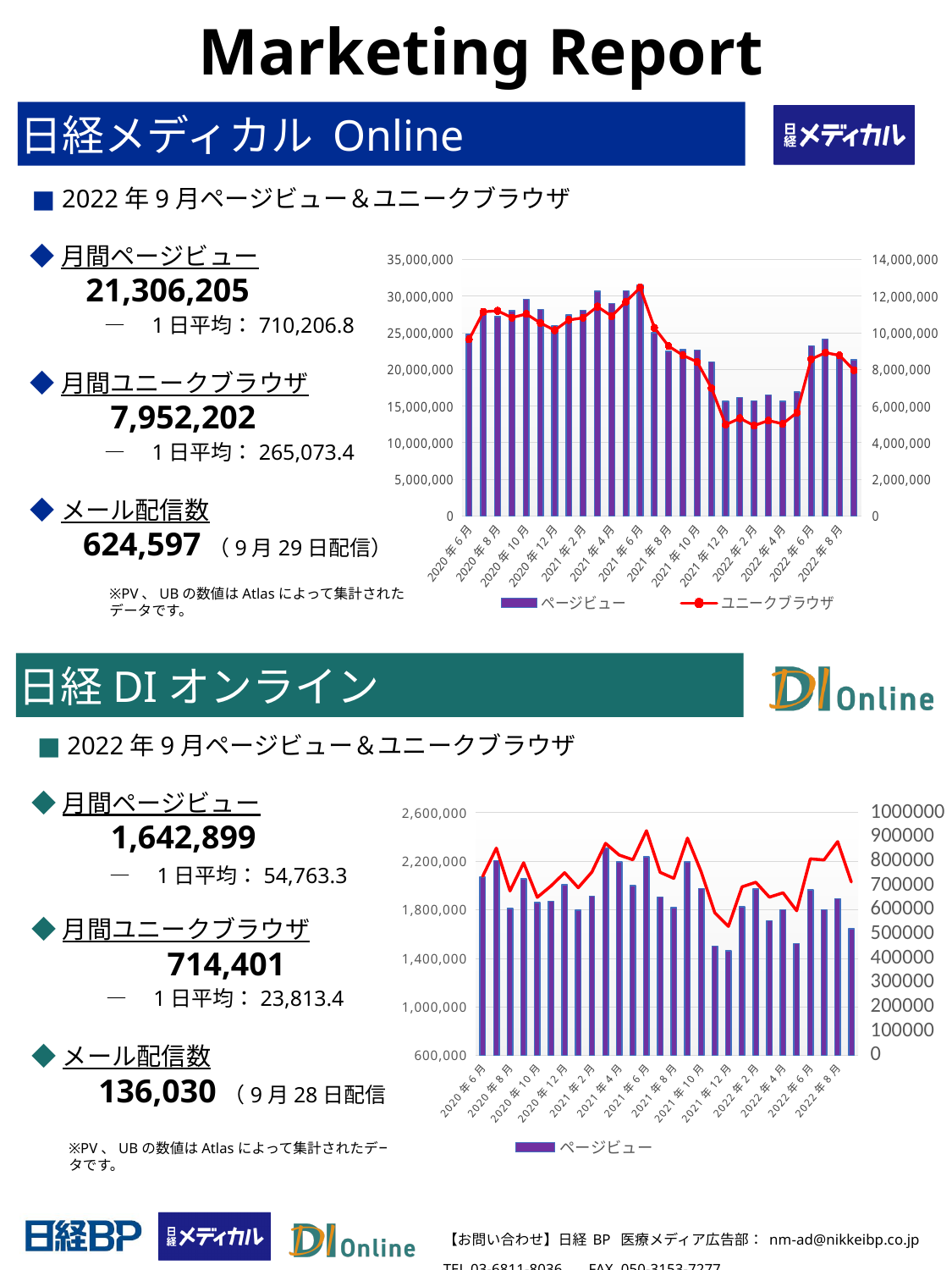
How many series does the legend of the 日経メディカル Online chart list? 2 In the 日経 DI オンライン chart, is the ページビュー bar for 2020年6月 greater or less than 1,800,000? greater What kind of chart is shown in the 日経メディカル Online section? Combined bar and line chart In the 日経メディカル Online chart, is the ページビュー bar for 2022年1月 greater or less than 20,000,000? less In the 日経メディカル Online chart, which series is drawn as a red line according to the legend? ユニークブラウザ In the 日経メディカル Online chart, is the ページビュー bar for 2021年6月 greater or less than 25,000,000? greater In the 日経 DI オンライン chart, which has the larger ページビュー bar, 2021年4月 or 2022年9月? 2021年4月 In the 日経メディカル Online chart, which has the larger ページビュー bar, 2021年6月 or 2022年1月? 2021年6月 What kind of chart is shown in the 日経 DI オンライン section? Combined bar and line chart In the 日経メディカル Online chart, do the ページビュー bars rise or fall from 2021年6月 to 2022年1月? fall How many entries does the legend of the 日経 DI オンライン chart list? 1